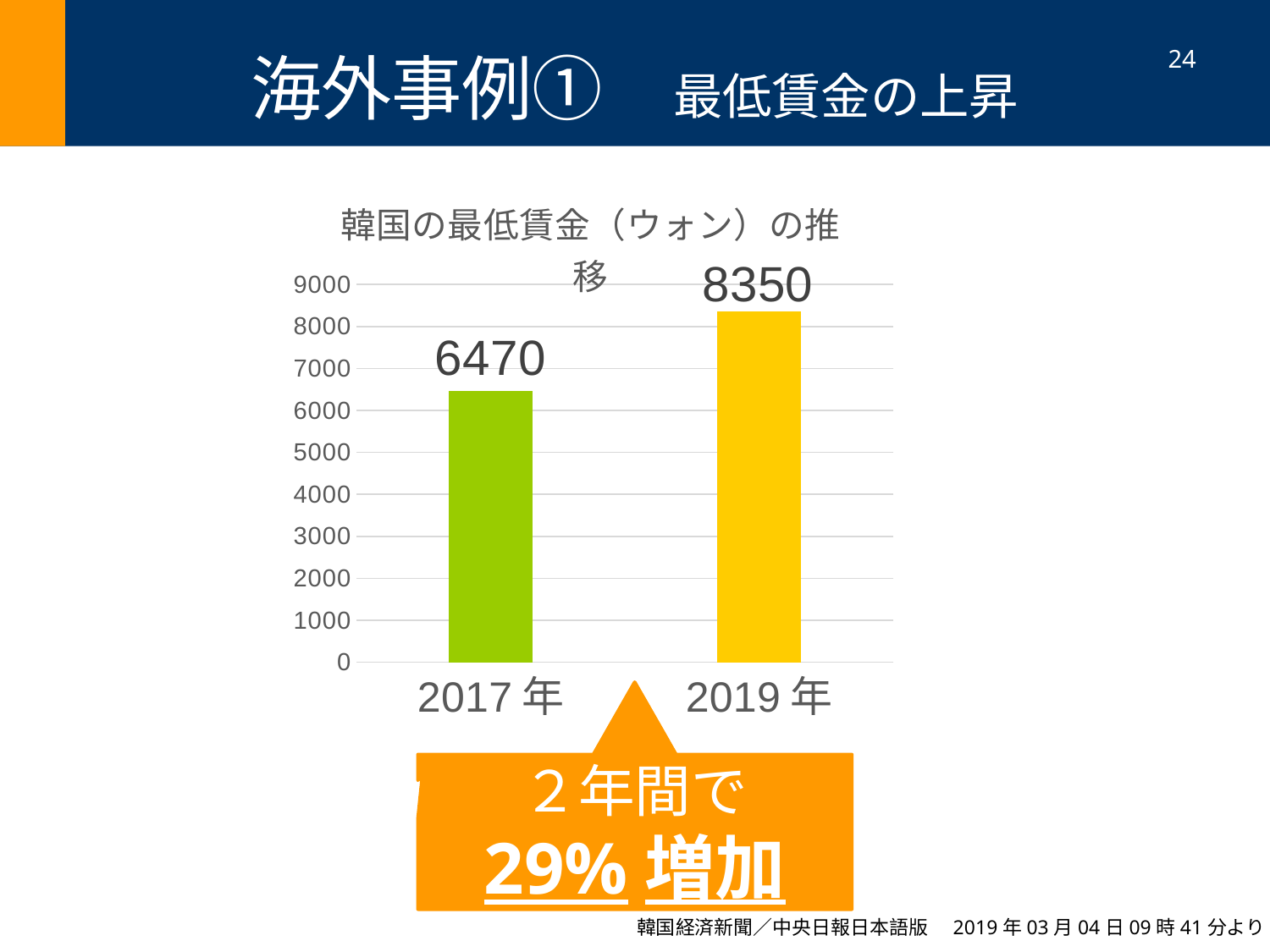
Do the values rise or fall from 2017年 to 2019年? rise What kind of chart is shown? bar chart Is the value for 2017年 greater or less than 7000? less Is the value for 2019年 greater or less than 8000? greater What is the value for 2017年? 6470 How many categories are shown on the x axis? 2 What is the value for 2019年? 8350 Is the value for 2017年 larger or smaller than the value for 2019年? smaller Which year has the lower minimum wage? 2017年 What is the title of the chart? 韓国の最低賃金（ウォン）の推移 Which year has the higher minimum wage? 2019年 What is the difference between the 2019年 and 2017年 values? 1880